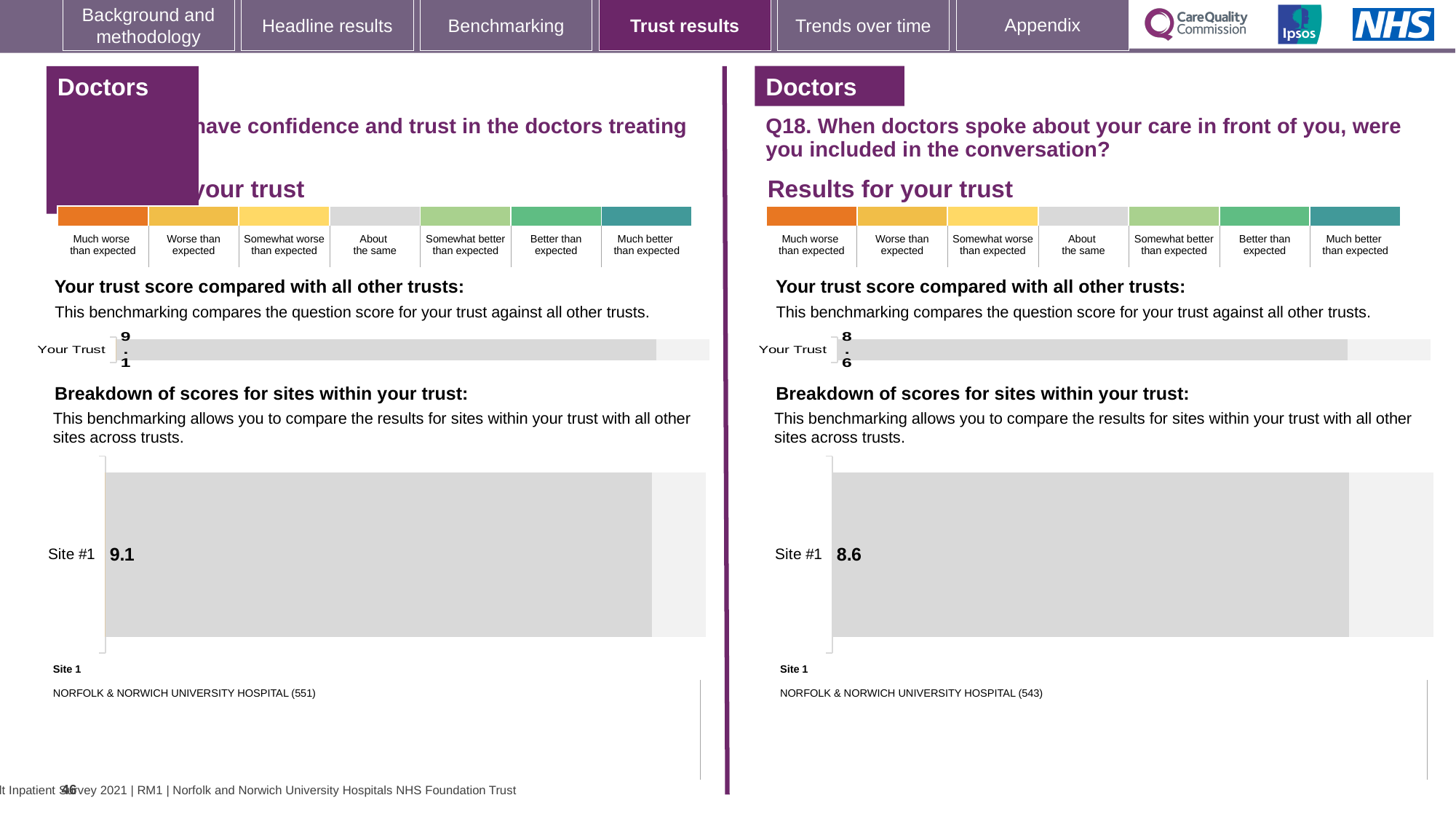
Which is larger: the Your Trust score on the left panel or the Your Trust score on the right panel (Q18)? Left panel (9.1) What type of chart is used to show the Site #1 score on the left panel? Bar chart What is the difference between the Site #1 score on the left panel and the Site #1 score on the right panel (Q18)? 0.5 What is the question text shown above the charts on the right panel? Q18. When doctors spoke about your care in front of you, were you included in the conversation? Which site is listed as Site 1 on the right panel (Q18)? NORFOLK & NORWICH UNIVERSITY HOSPITAL (543) On the right panel (Q18), what is the score for Site #1 in the 'Breakdown of scores for sites within your trust' chart? 8.6 On the left panel, what is the score shown for Your Trust in the 'Your trust score compared with all other trusts' chart? 9.1 On the left panel, is the Site #1 score the same as the Your Trust score? Yes, both 9.1 On the right panel (Q18), what is the score shown for Your Trust in the 'Your trust score compared with all other trusts' chart? 8.6 On the left panel, what is the score for Site #1 in the 'Breakdown of scores for sites within your trust' chart? 9.1 How many sites are shown in the 'Breakdown of scores for sites within your trust' chart on the right panel (Q18)? 1